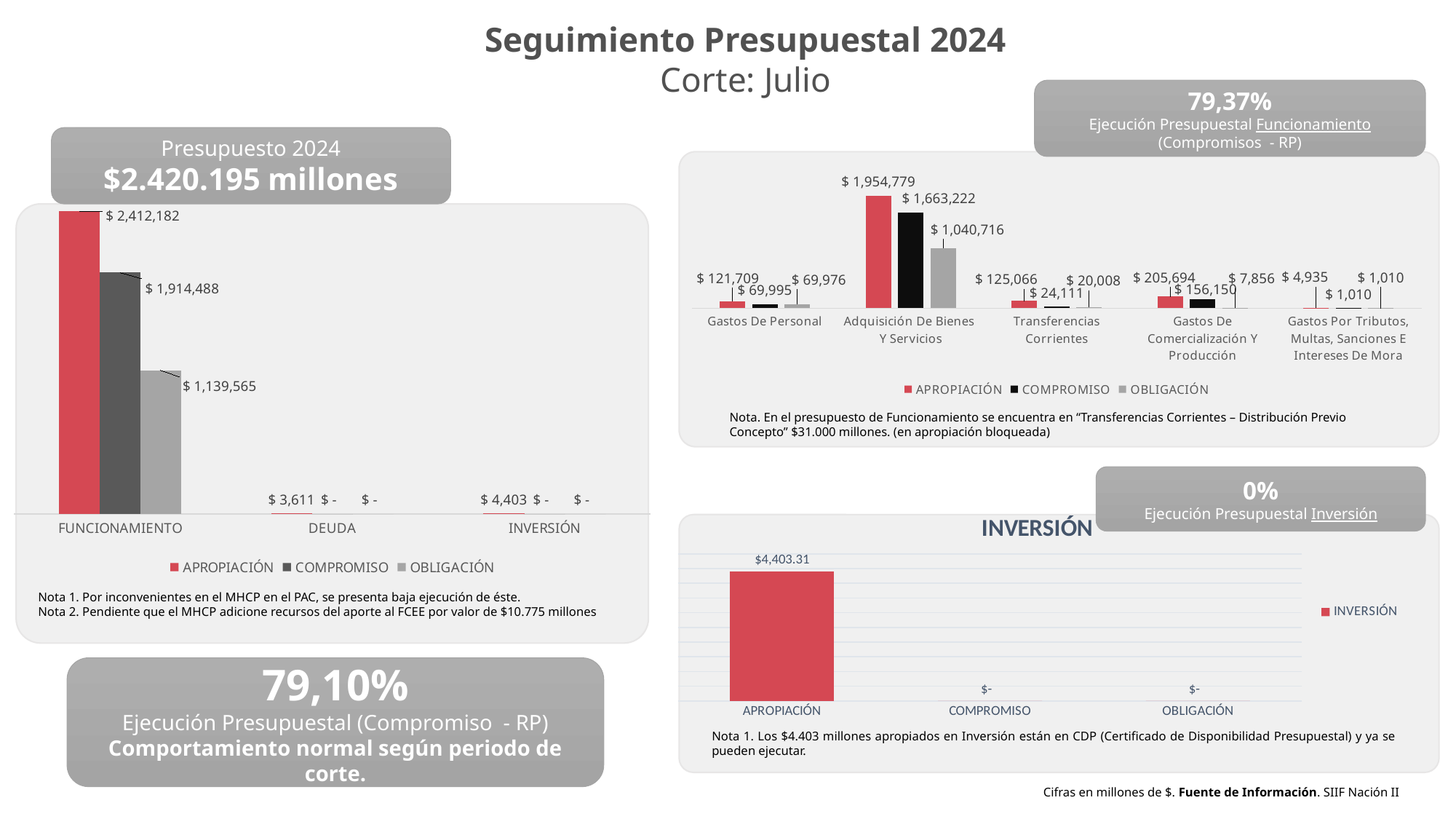
In the top-right chart, what is the APROPIACIÓN value for Adquisición De Bienes Y Servicios? $ 1,954,779 In the left chart, what is the difference between the APROPIACIÓN and COMPROMISO values for FUNCIONAMIENTO? $ 497,694 In the left chart, what is the OBLIGACIÓN value for FUNCIONAMIENTO? $ 1,139,565 In the top-right chart, which category has the lowest APROPIACIÓN value? Gastos Por Tributos, Multas, Sanciones E Intereses De Mora In the left chart, what is the APROPIACIÓN value for FUNCIONAMIENTO? $ 2,412,182 In the left chart, what is the APROPIACIÓN value for DEUDA? $ 3,611 In the top-right chart, how many categories are shown on the x axis? 5 In the top-right chart, what is the OBLIGACIÓN value for Gastos De Comercialización Y Producción? $ 7,856 In the top-right chart, which category has the highest APROPIACIÓN value? Adquisición De Bienes Y Servicios In the left chart, how many series does the legend list? 3 What kind of chart is the bottom-right INVERSIÓN chart? Bar chart In the bottom-right INVERSIÓN chart, what is the value for APROPIACIÓN? $4,403.31